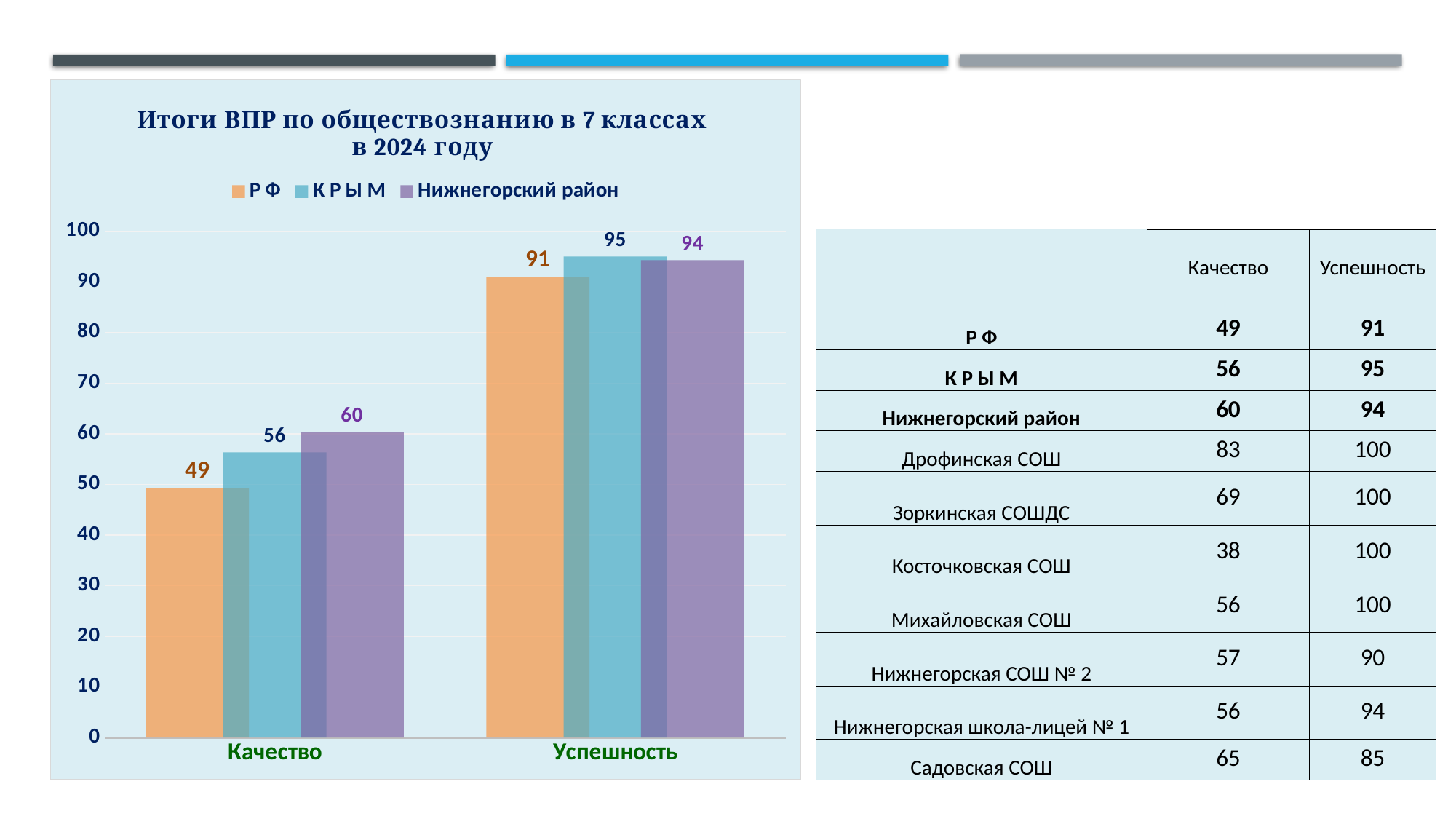
Which series has the highest value in the Качество category? Нижнегорский район How many series does the legend list? 3 How many categories are shown on the x axis? 2 What is the value for К Р Ы М in the Успешность category? 95 Which series has the lowest value in the Успешность category? Р Ф What kind of chart is shown on the slide? Bar chart What is the title of the chart? Итоги ВПР по обществознанию в 7 классах в 2024 году Which is larger in the Успешность category: К Р Ы М or Нижнегорский район? К Р Ы М What is the value for Нижнегорский район in the Качество category? 60 What is the value for Р Ф in the Качество category? 49 What is the value for Нижнегорский район in the Успешность category? 94 What is the difference between the Нижнегорский район and Р Ф values in the Качество category? 11